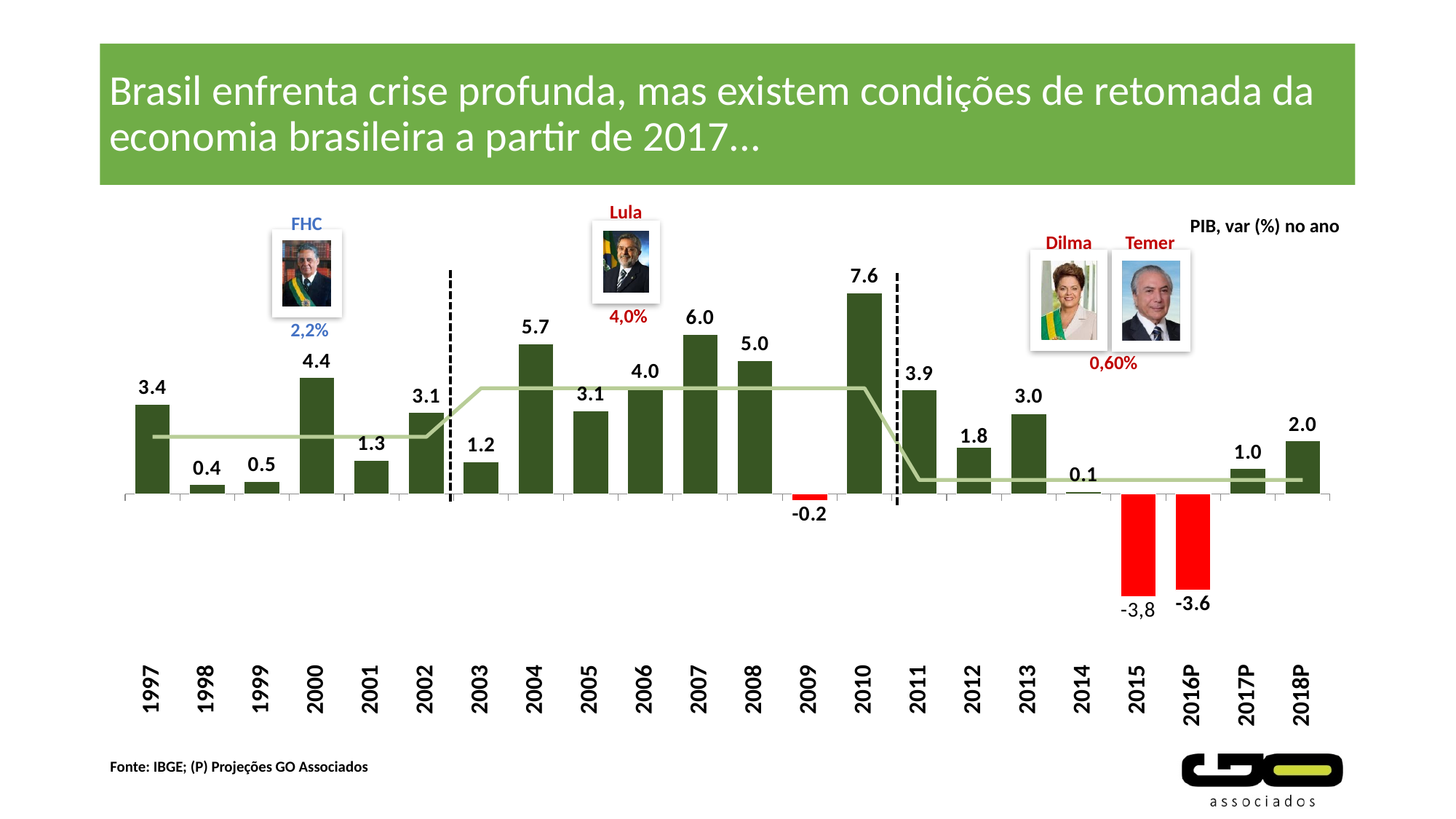
How many years are shown on the x axis? 22 What is the source cited for the chart data? IBGE; (P) Projeções GO Associados What is the difference between the values for 2010 and 2007? 1.6 What is the value for 2010? 7.6 Which year has the highest value? 2010 What kind of chart is this? Combination bar and line chart What average value is shown for the Lula period? 4,0% What is the value for 2018P? 2.0 Which is larger, the value for 2004 or the value for 2008? 2004 Do the values rise or fall from 2015 to 2018P? Rise Which year has the lowest value? 2015 What is the value for 2015? -3,8